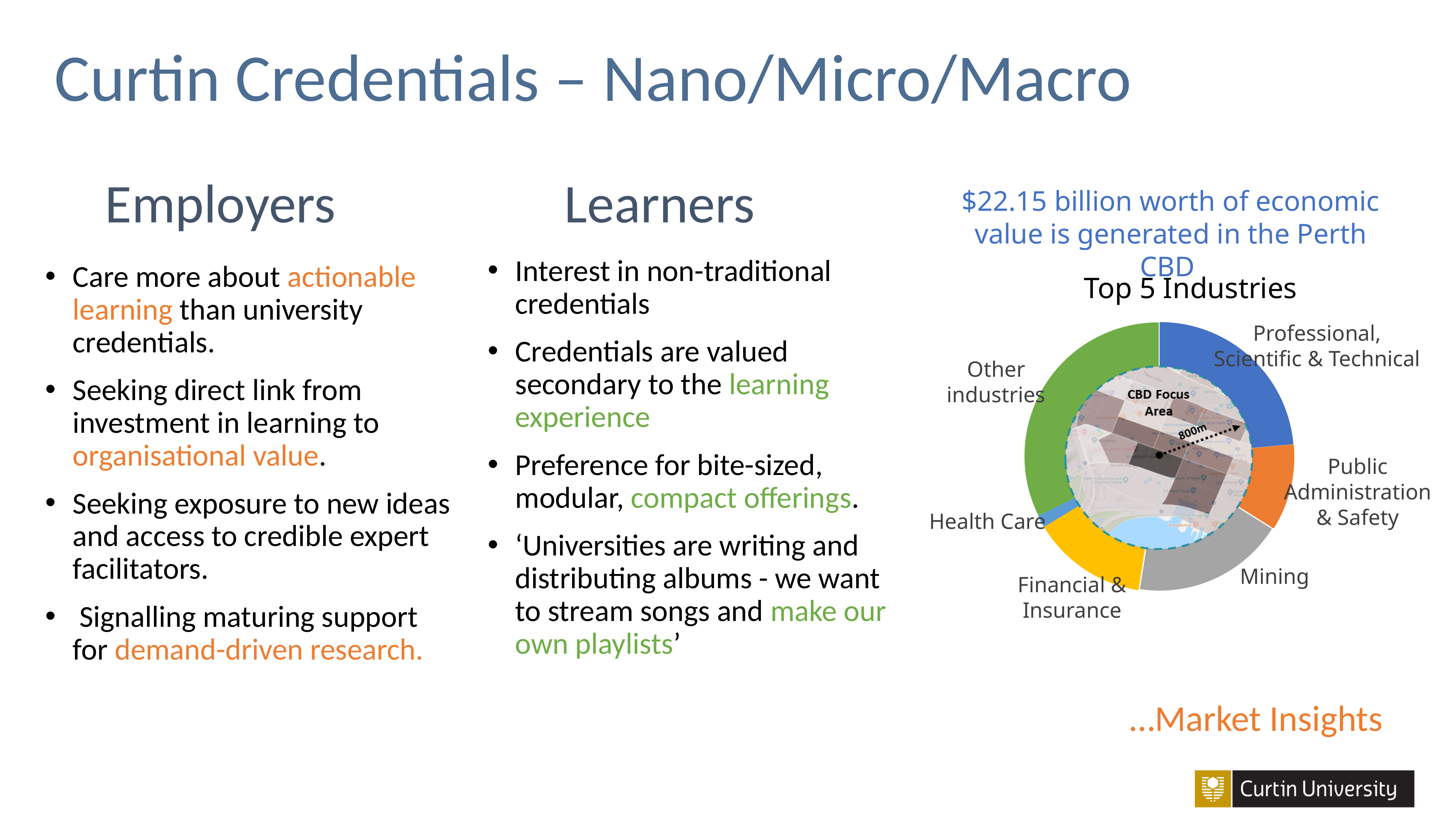
In the "Top 5 Industries" chart, which is larger: Mining or Public Administration & Safety? Mining Which segment of the "Top 5 Industries" chart is the largest? Other industries What kind of chart is the "Top 5 Industries" chart? Doughnut chart In the "Top 5 Industries" chart, which is larger: Professional, Scientific & Technical or Mining? Professional, Scientific & Technical How many segments does the "Top 5 Industries" chart have? 6 Which segment of the "Top 5 Industries" chart is the smallest? Health Care What is the title of the chart on the right of the slide? Top 5 Industries In the "Top 5 Industries" chart, which is larger: Other industries or Professional, Scientific & Technical? Other industries What colour is the Mining segment in the "Top 5 Industries" chart? Grey